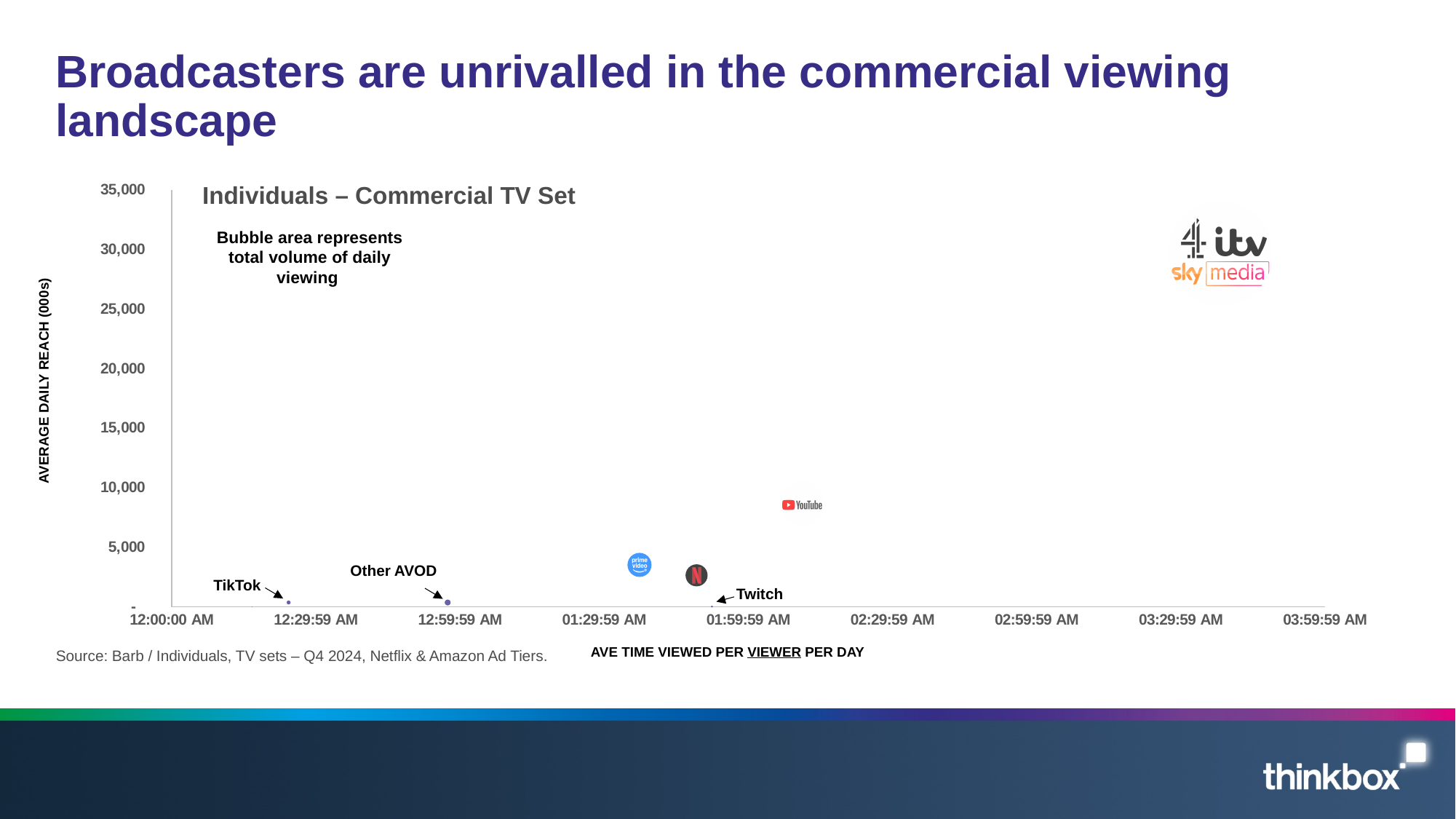
Is the average daily reach for Netflix greater or less than 5,000? less Is the average daily reach for TikTok greater or less than 5,000? less What kind of chart is shown on the slide? bubble chart Which has the higher average time viewed per viewer per day, Twitch or TikTok? Twitch Is the average daily reach for Prime Video greater or less than 5,000? less What is the title of the chart? Individuals – Commercial TV Set Which has the higher average time viewed per viewer per day, TikTok or Other AVOD? Other AVOD Which has the higher average time viewed per viewer per day, YouTube or Prime Video? YouTube What does the bubble area represent in the chart? total volume of daily viewing